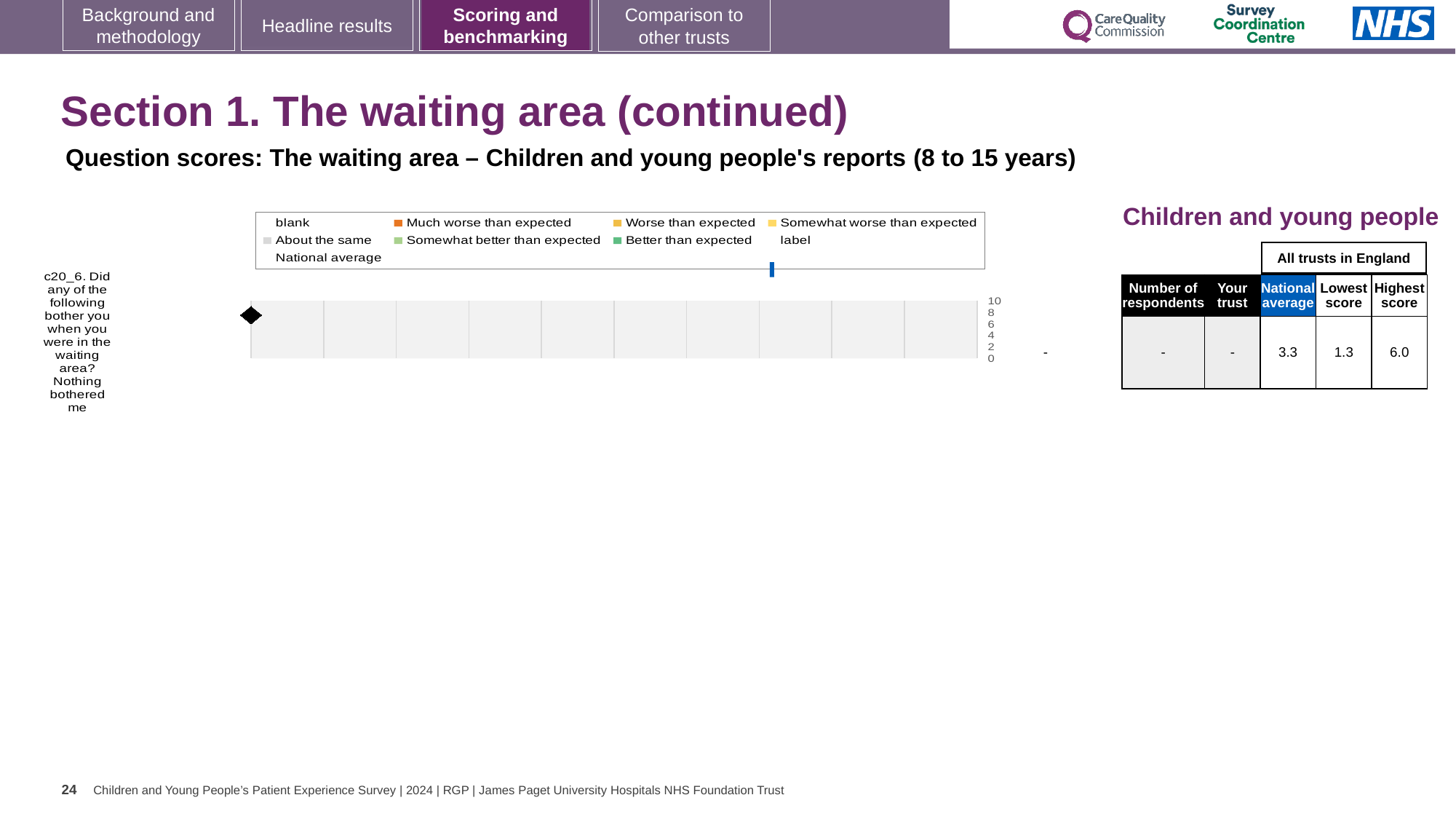
How many question categories are plotted on the chart? 1 What kind of chart is shown on the slide? bar chart What data label is shown for the bar for question c20_6 (Nothing bothered me)? - What colour is the legend marker for 'Much worse than expected'? orange How many entries does the chart legend list? 9 What is the highest value shown on the chart's axis? 10